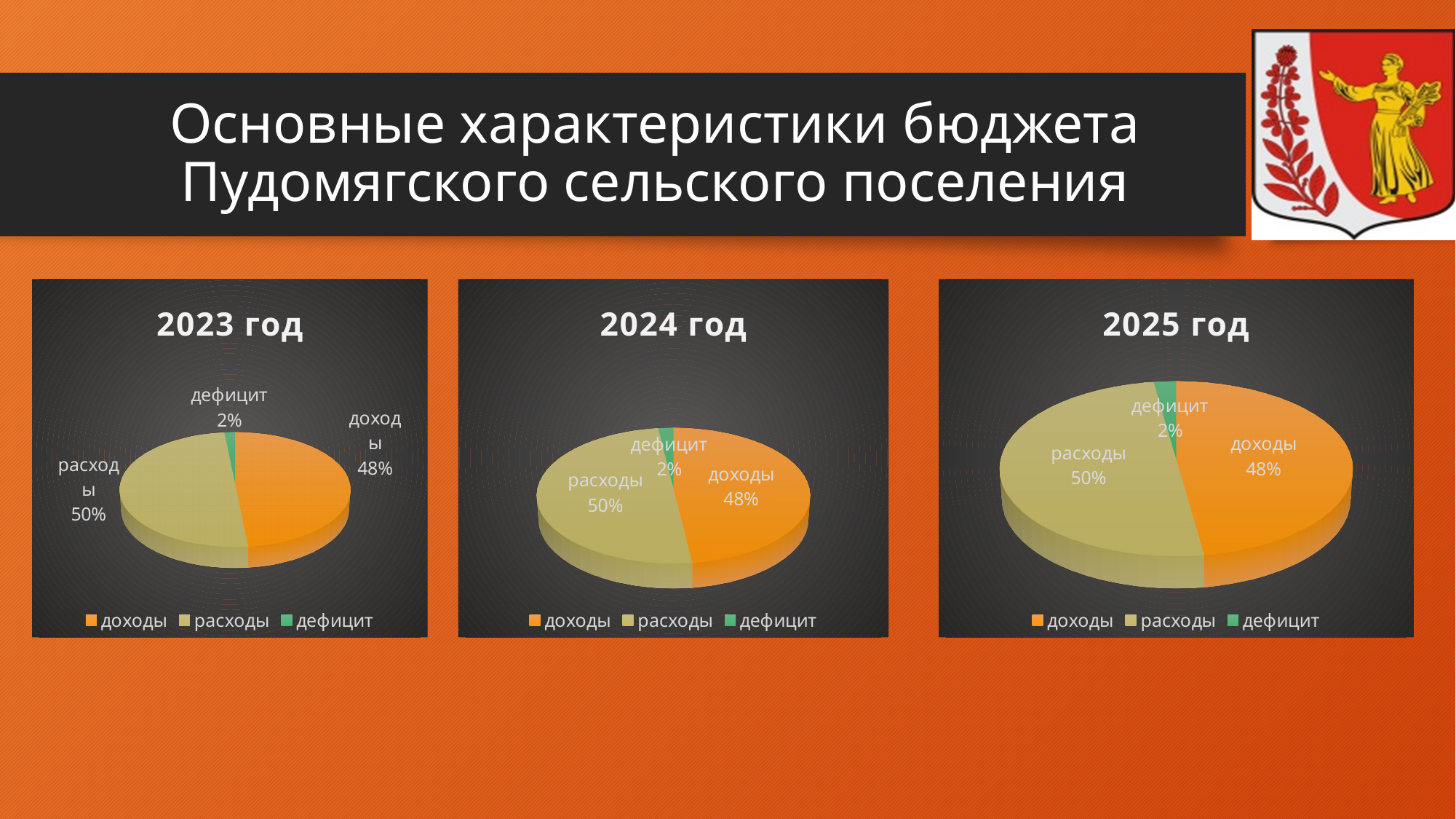
In the "2023 год" chart, which slice is the largest? расходы In the "2024 год" chart, what colour is the дефицит slice? green In the "2023 год" chart, which is larger, доходы or дефицит? доходы In the "2023 год" chart, what share does доходы have? 48% What kind of chart is the "2023 год" chart? pie chart In the "2024 год" chart, what share does расходы have? 50% How many entries does the legend of the "2025 год" chart list? 3 How many slices does the "2024 год" chart have? 3 In the "2025 год" chart, what is the difference between the расходы share and the доходы share? 2% In the "2025 год" chart, what share does дефицит have? 2% In the "2024 год" chart, which slice is the smallest? дефицит How many charts are on the slide? 3